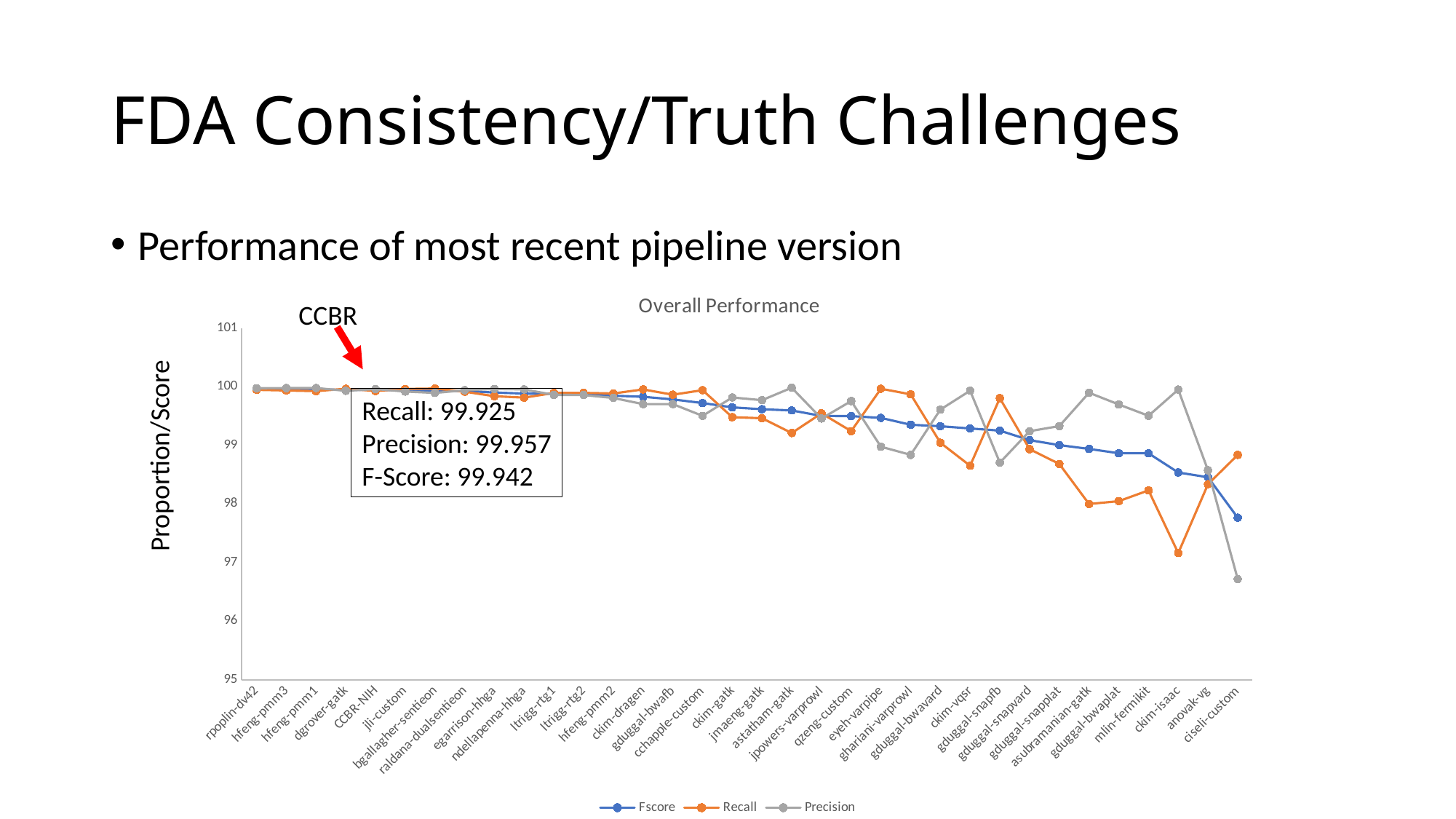
Is the Precision value for ciseli-custom greater or less than 97? less Which pipeline has the lowest Fscore? ciseli-custom What is the F-Score value for CCBR-NIH shown in the annotation box? 99.942 What is the Recall value for CCBR-NIH shown in the annotation box? 99.925 What type of chart is shown on the slide? line chart Does the Fscore series generally rise or fall from left to right along the x axis? fall What is the Precision value for CCBR-NIH shown in the annotation box? 99.957 Which pipeline has the lowest Recall? ckim-isaac How many series does the legend list? 3 What is the title of the chart? Overall Performance What is the difference between the Precision and Recall values for CCBR-NIH? 0.032 What is the y-axis label of the chart? Proportion/Score